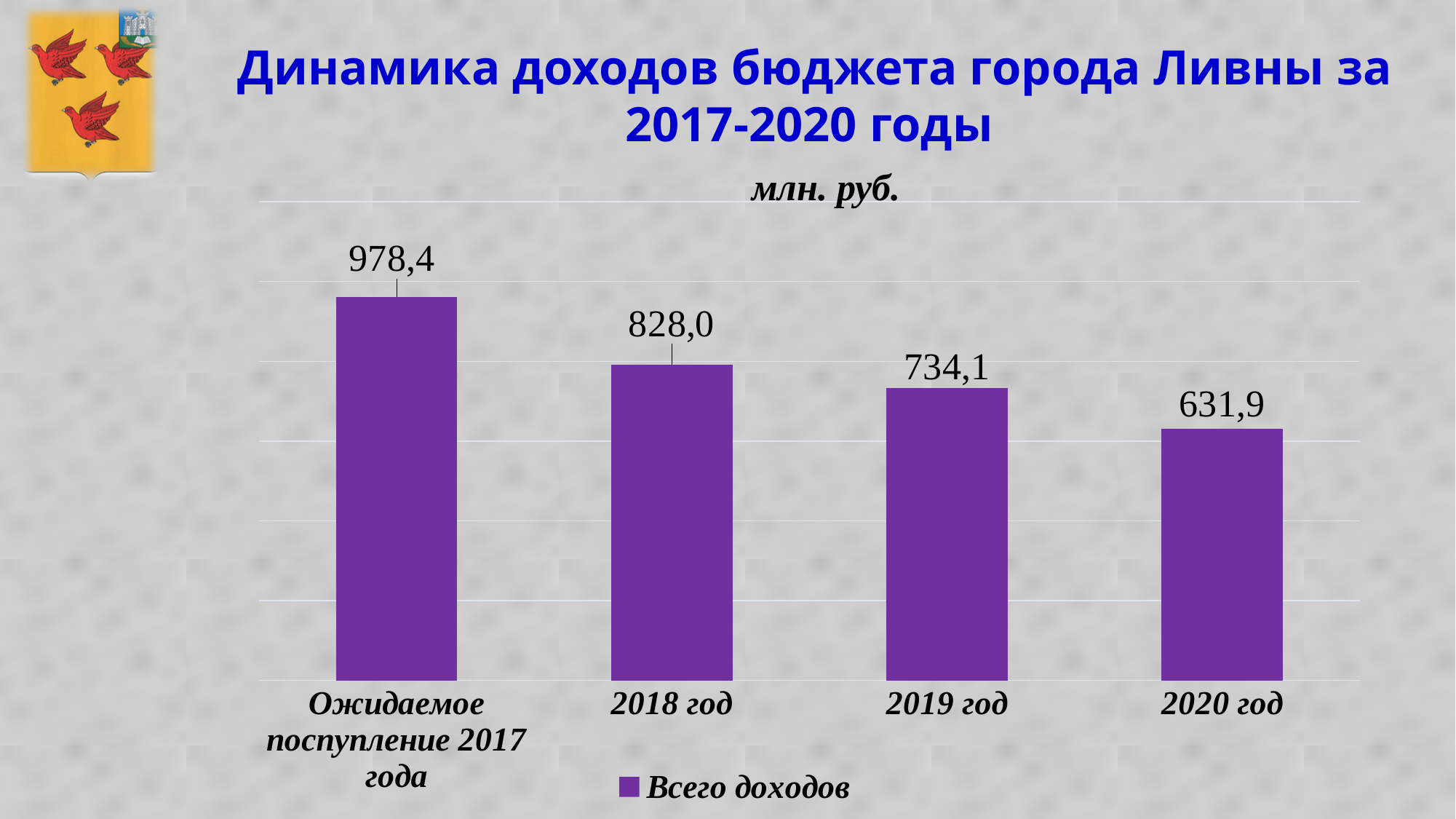
Which category has the lowest value? 2020 год What is the value for 2019 год? 734,1 What is the difference between the values for 2018 год and 2020 год? 196,1 How many bars are in the chart? 4 What kind of chart is shown? Bar chart What is the value for 2018 год? 828,0 Which is larger, the value for 2019 год or the value for 2020 год? 2019 год What is the difference between the values for Ожидаемое поступление 2017 года and 2018 год? 150,4 What is the value for 2020 год? 631,9 Do the values rise or fall from left to right along the x axis? Fall What is the value for Ожидаемое поступление 2017 года? 978,4 Which category has the highest value? Ожидаемое поступление 2017 года